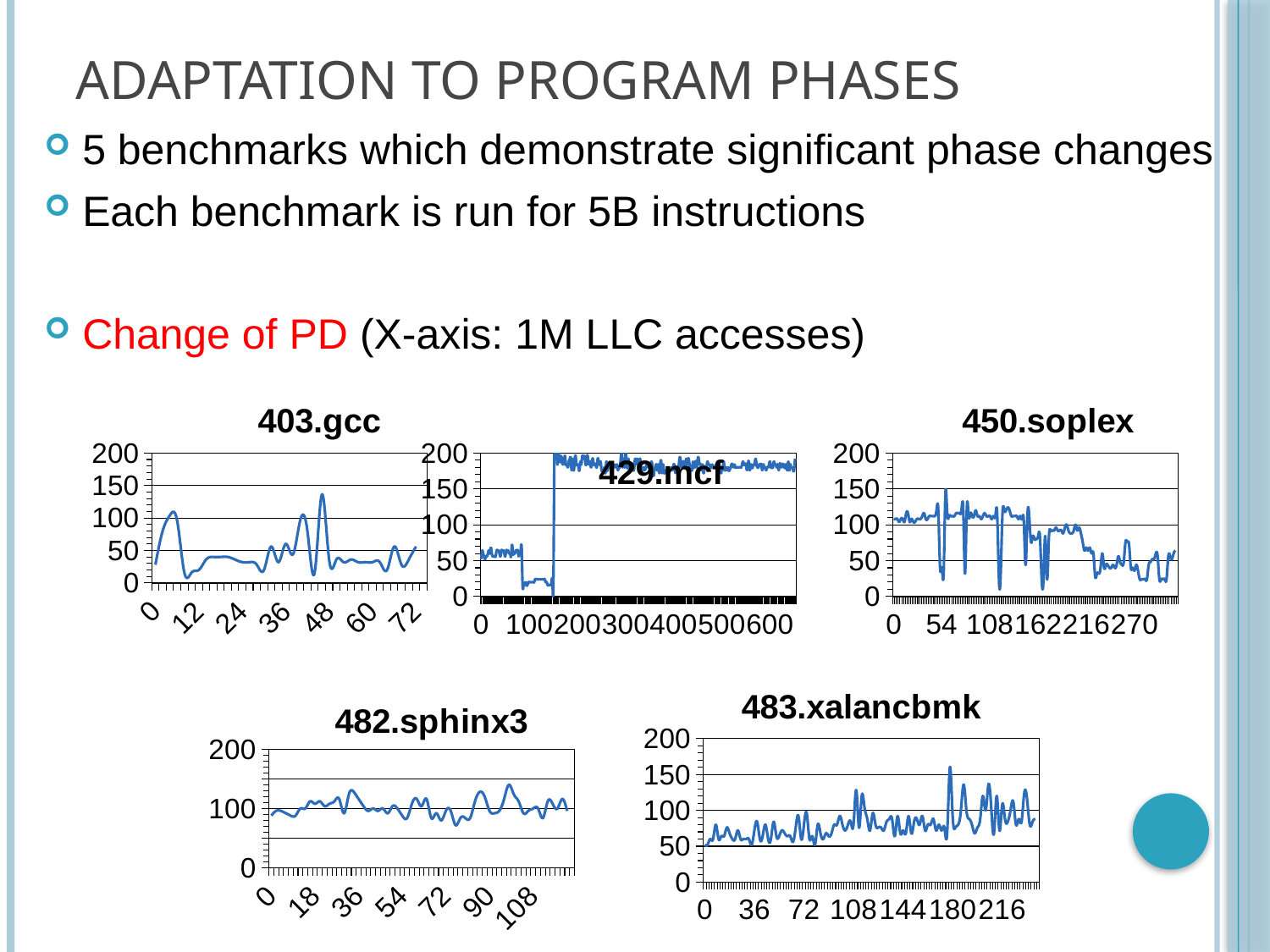
How many charts are shown on the slide? 5 In the 450.soplex chart, are the values at the start of the x axis greater or less than 150? less In the 482.sphinx3 chart, is the lowest value greater or less than 50? greater What kind of chart is the 403.gcc chart? line chart In the 483.xalancbmk chart, is the highest peak greater or less than 100? greater How many data series are plotted in the 450.soplex chart? 1 In the 429.mcf chart, are the values before x=100 larger or smaller than the values after x=300? smaller In the 450.soplex chart, do the values overall rise or fall along the x axis? fall What is the maximum value shown on the y axis of the 483.xalancbmk chart? 200